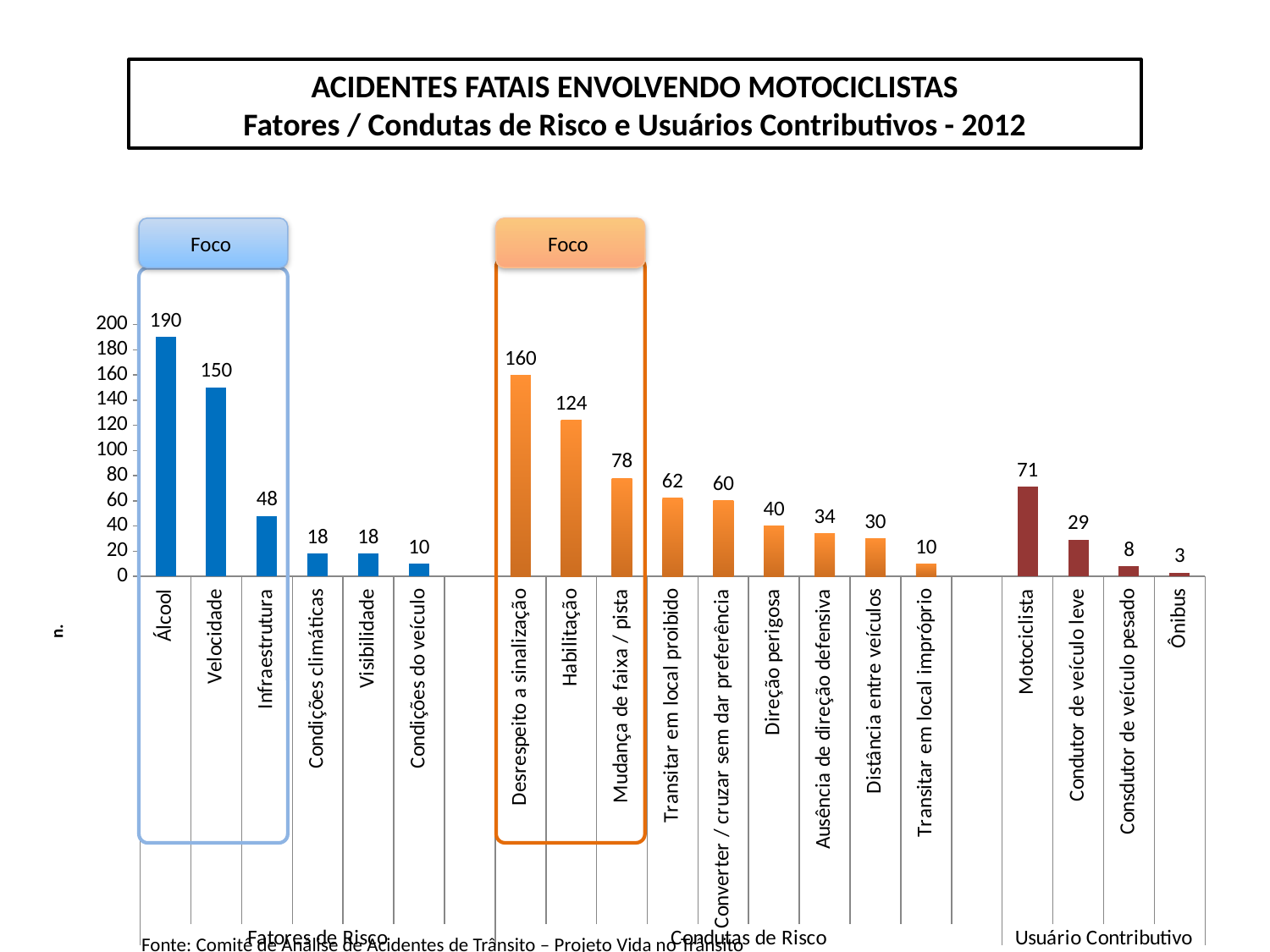
Which category has the highest value? Álcool What is the value for Álcool? 190 Which category has the lowest value? Ônibus What is the difference between the values for Álcool and Velocidade? 40 What is the value for Habilitação? 124 What is the difference between the values for Desrespeito a sinalização and Habilitação? 36 How many categories are in the Condutas de Risco group? 9 What kind of chart is shown on the slide? Bar chart Which is larger, the value for Mudança de faixa / pista or the value for Motociclista? Mudança de faixa / pista What is the value for Motociclista? 71 What is the title of the chart? ACIDENTES FATAIS ENVOLVENDO MOTOCICLISTAS Fatores / Condutas de Risco e Usuários Contributivos - 2012 How many categories are plotted in the chart? 19